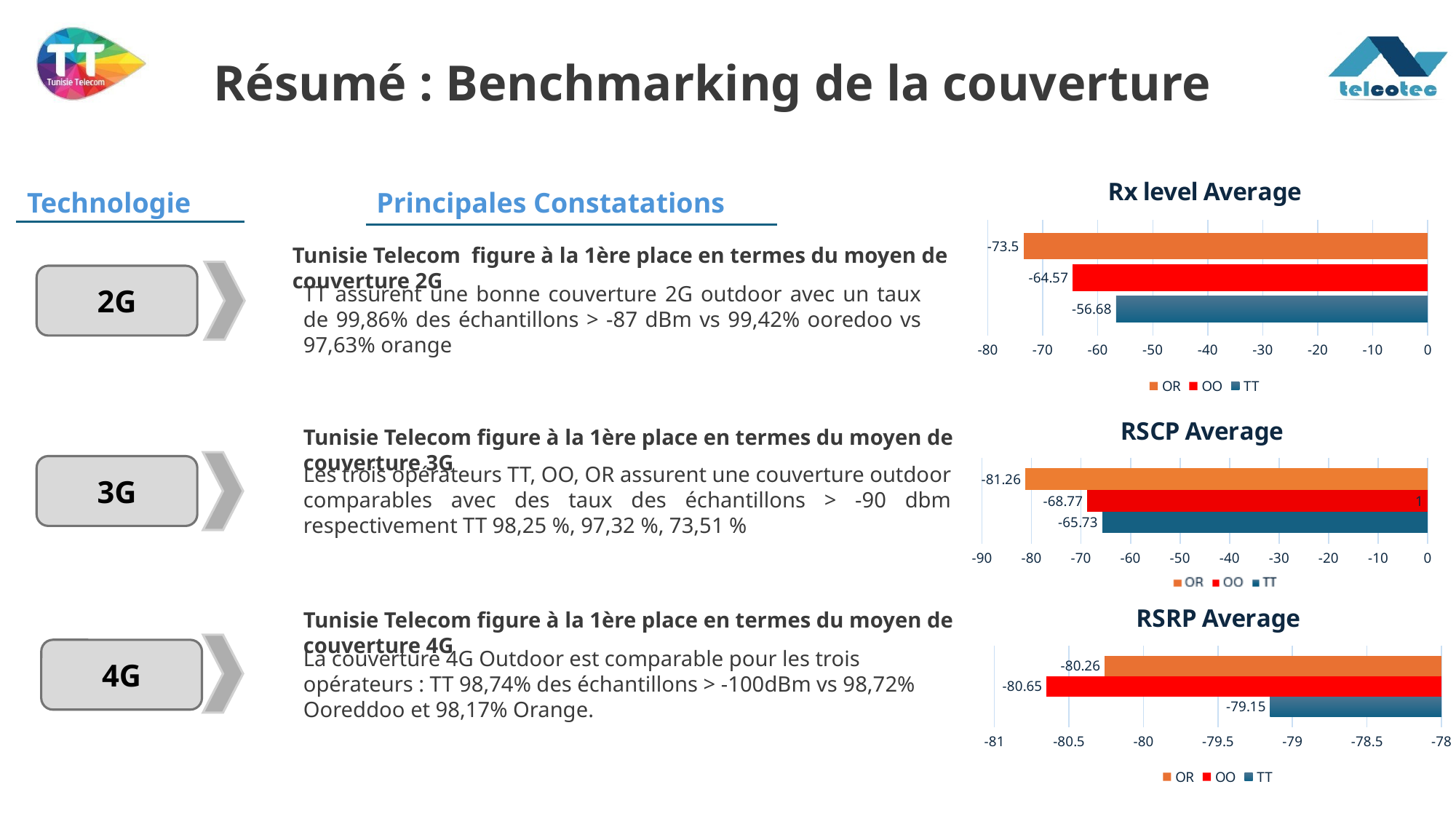
In the RSRP Average chart, which series has the lowest value? OO In the Rx level Average chart, what is the value for TT? -56.68 What type of chart is the RSCP Average chart? Bar chart In the RSRP Average chart, what is the value for TT? -79.15 In the RSRP Average chart, what is the difference between the TT value and the OO value? 1.5 In the RSCP Average chart, what is the value for OO? -68.77 In the RSCP Average chart, which series has the lowest value? OR In the RSCP Average chart, which is larger, the value for OO or the value for OR? OO In the Rx level Average chart, what is the difference between the TT value and the OR value? 16.82 In the Rx level Average chart, which series has the highest value? TT In the Rx level Average chart, what is the value for OR? -73.5 How many series does the legend of the RSRP Average chart list? 3